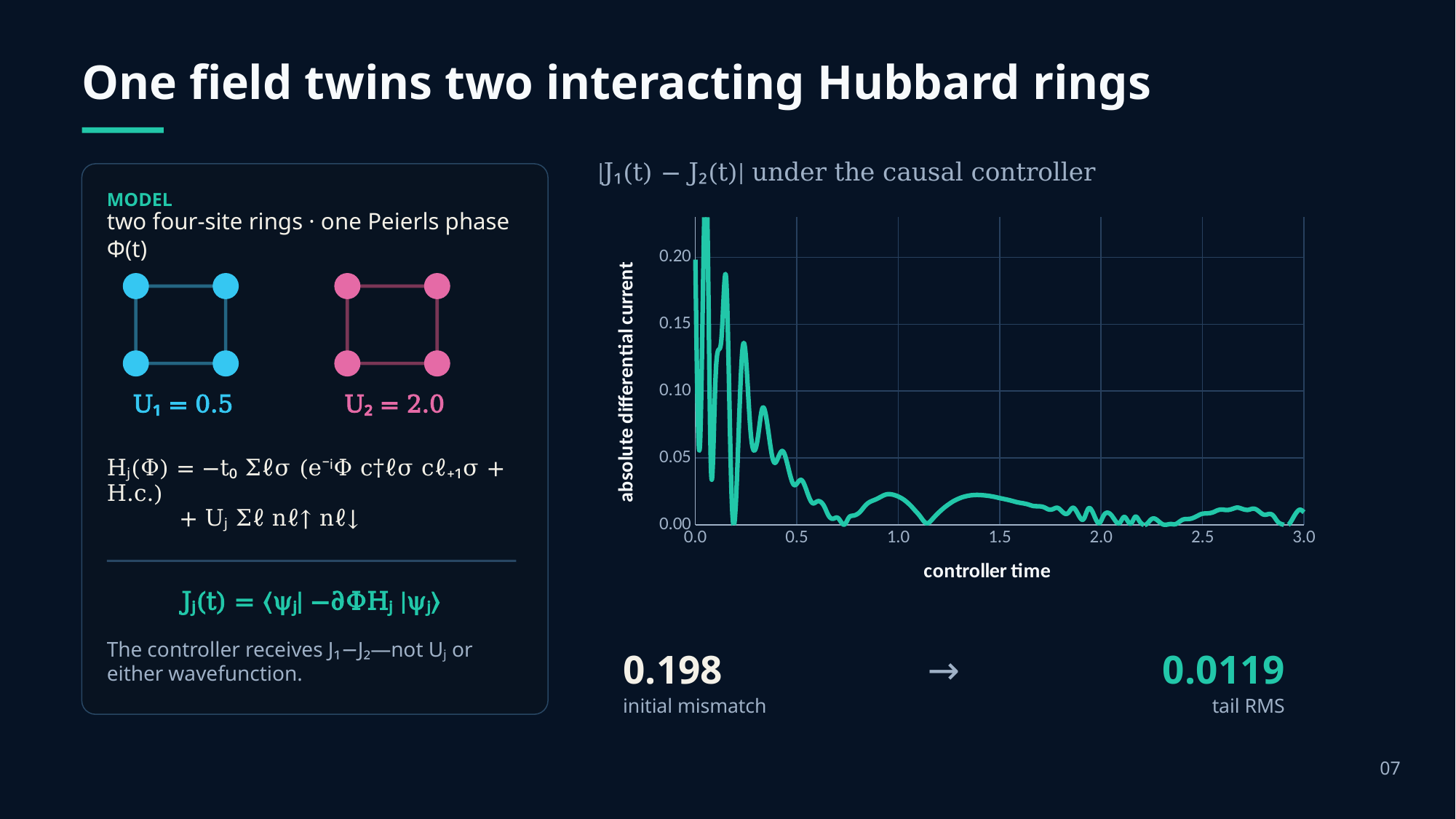
Is the value of the absolute differential current at controller time 2.5 greater or less than 0.10? less What kind of chart is shown on the slide? line chart What initial mismatch value is printed below the chart? 0.198 What tail RMS value is printed below the chart? 0.0119 What is the highest tick value shown on the y axis of the chart? 0.20 Is the value of the absolute differential current at controller time 1.0 greater or less than 0.05? less How many lines (series) are plotted on the chart? 1 What is the title of the chart? |J₁(t) − J₂(t)| under the causal controller Does the absolute differential current generally rise or fall as controller time increases? fall Near which end of the controller time axis does the absolute differential current reach its highest values, the start (near 0.0) or the end (near 3.0)? the start (near 0.0) Is the value of the absolute differential current at controller time 2.0 greater or less than 0.05? less What is the label of the chart's x axis? controller time